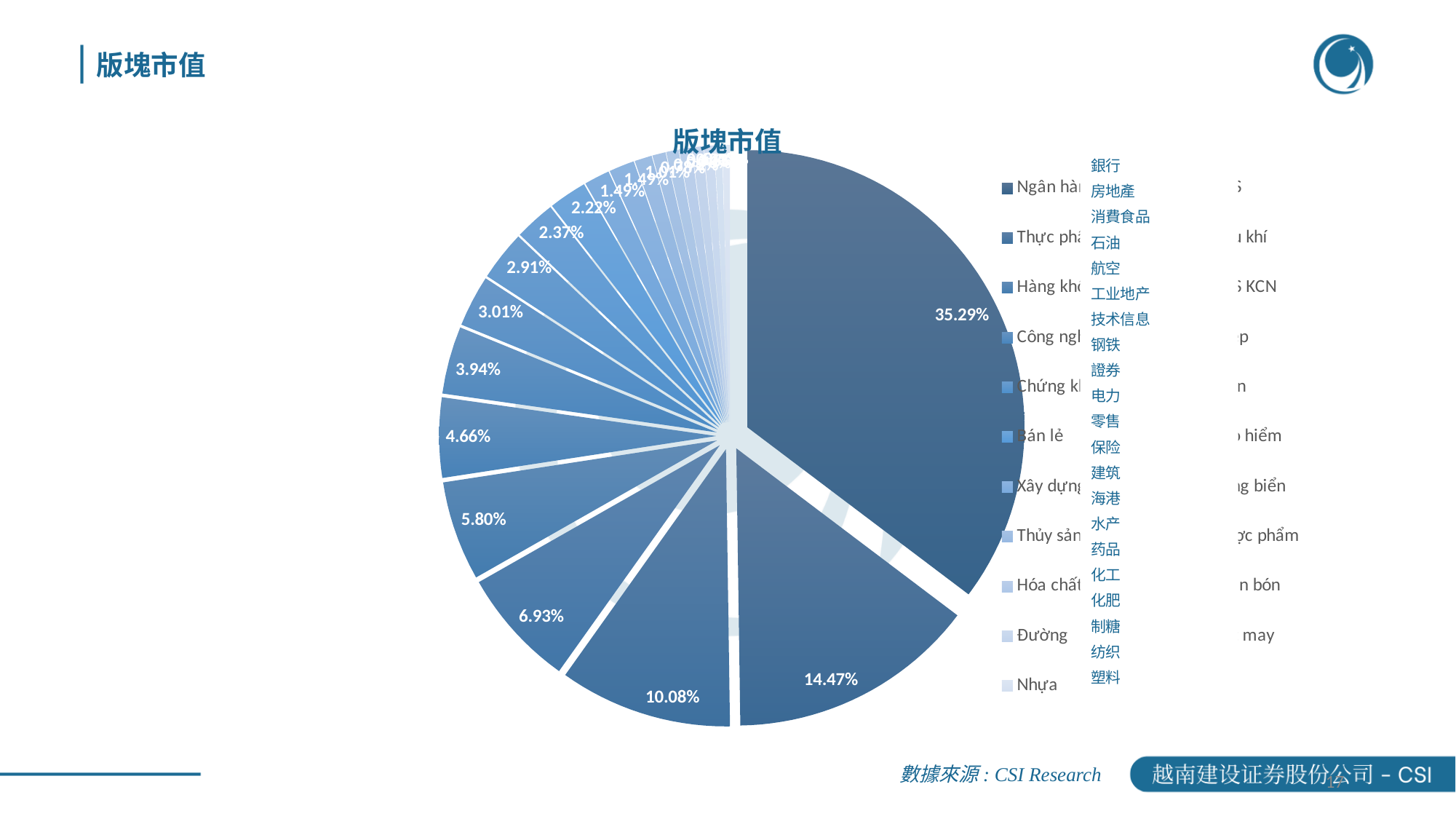
What is the value of the third-largest slice in the pie chart? 10.08% Is the largest slice of the pie greater or less than 30%? greater What is the difference between the largest slice (35.29%) and the second-largest slice (14.47%)? 20.82 percentage points What is the title of the chart? 版塊市值 What is the difference between the slices labelled 4.66% and 3.94%? 0.72 percentage points What is the combined share of the three largest slices (35.29%, 14.47% and 10.08%)? 59.84% What kind of chart is shown on the slide? Pie chart What is the data source cited below the chart? CSI Research What is the value of the largest slice in the pie chart? 35.29% Which category does the largest slice (35.29%) belong to? 銀行 (Ngân hàng) What is the value of the second-largest slice in the pie chart? 14.47% Which is larger, the slice labelled 6.93% or the slice labelled 5.80%? 6.93%